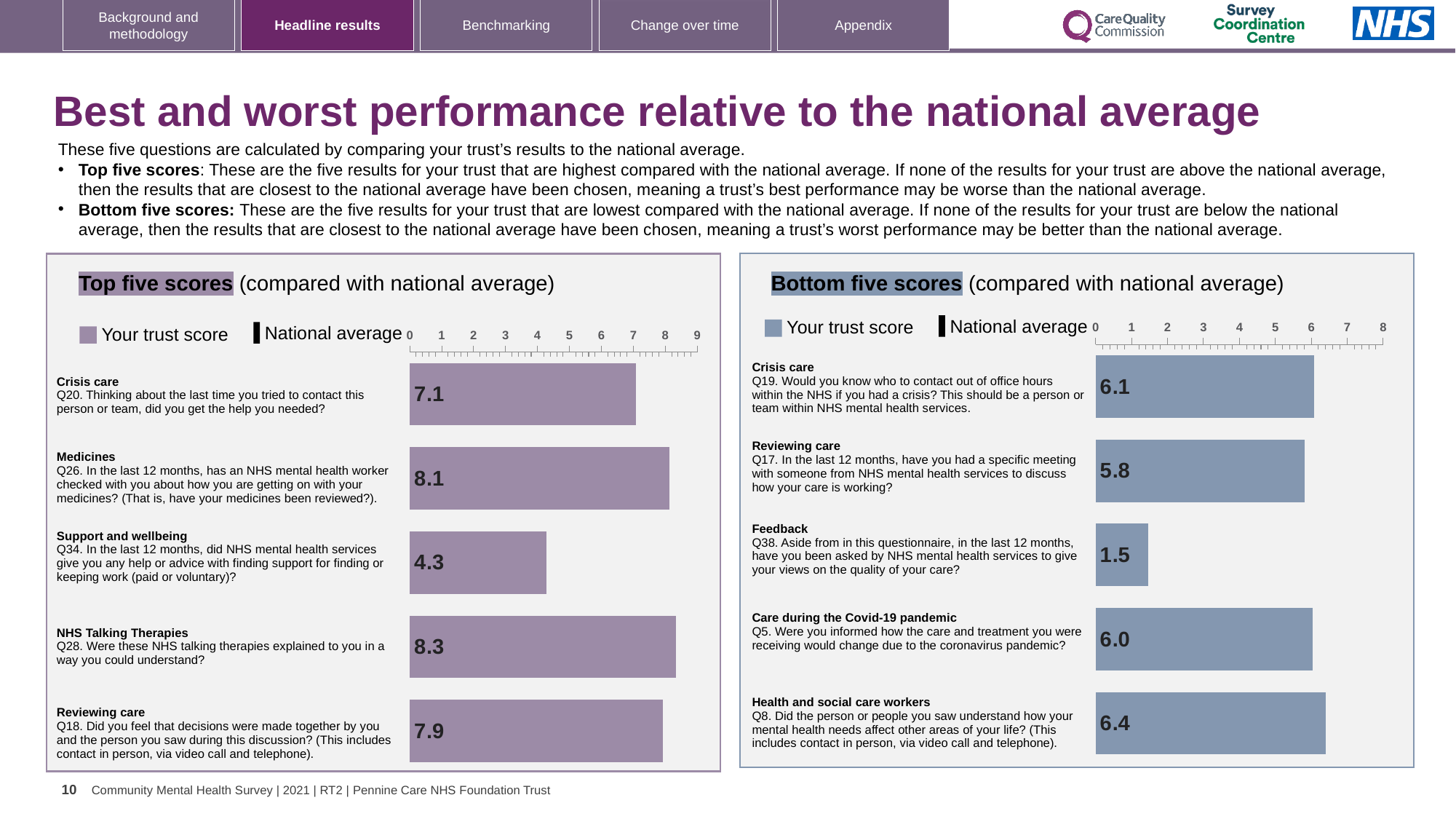
In the Top five scores chart, what is the trust score for Reviewing care (Q18)? 7.9 What type of chart is the Bottom five scores chart? Bar chart How many bars are plotted in the Top five scores chart? 5 In the Top five scores chart, which question has the lowest trust score? Support and wellbeing (Q34) In the Bottom five scores chart, which has the larger trust score: Crisis care (Q19) or Care during the Covid-19 pandemic (Q5)? Crisis care (Q19) In the Bottom five scores chart, what is the trust score for Feedback (Q38)? 1.5 In the Top five scores chart, which question has the highest trust score? NHS Talking Therapies (Q28) In the Top five scores chart, what is the trust score for Medicines (Q26)? 8.1 In the Bottom five scores chart, which question has the highest trust score? Health and social care workers (Q8) In the Bottom five scores chart, which question has the lowest trust score? Feedback (Q38) In the Top five scores chart, what is the difference between the trust scores for NHS Talking Therapies and Support and wellbeing? 4.0 In the Bottom five scores chart, what is the difference between the trust scores for Health and social care workers and Reviewing care? 0.6